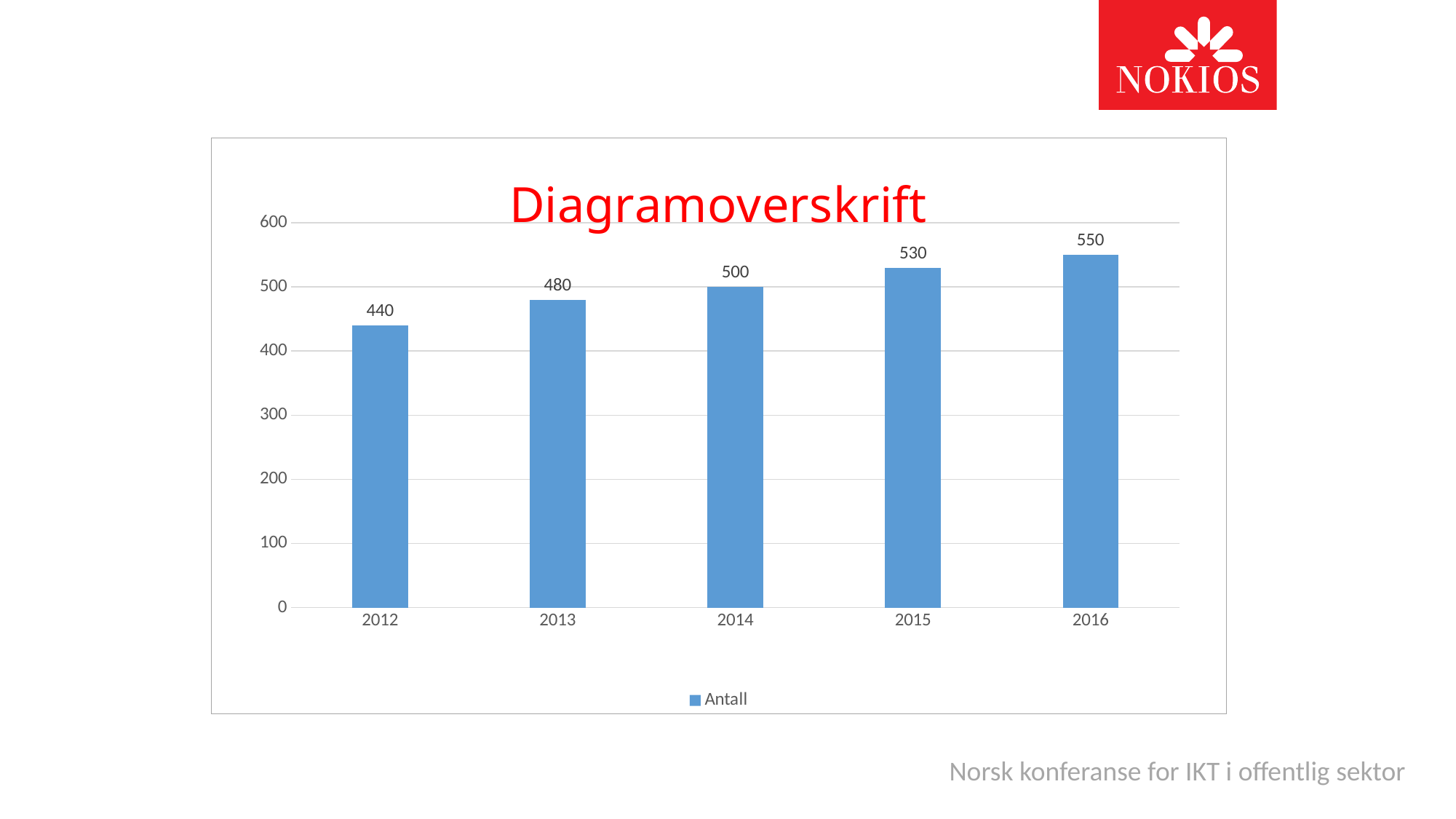
What is the difference between the values for 2015 and 2013? 50 What is the value for 2016? 550 Is the value for 2013 greater or less than 400? greater Which year has the lowest value? 2012 How many years are shown on the x axis? 5 What is the value for 2012? 440 What kind of chart is shown? bar chart Do the values rise or fall from 2012 to 2016? rise What is the value for 2014? 500 Which is larger, the value for 2013 or the value for 2015? 2015 Which year has the highest value? 2016 What is the difference between the values for 2016 and 2012? 110